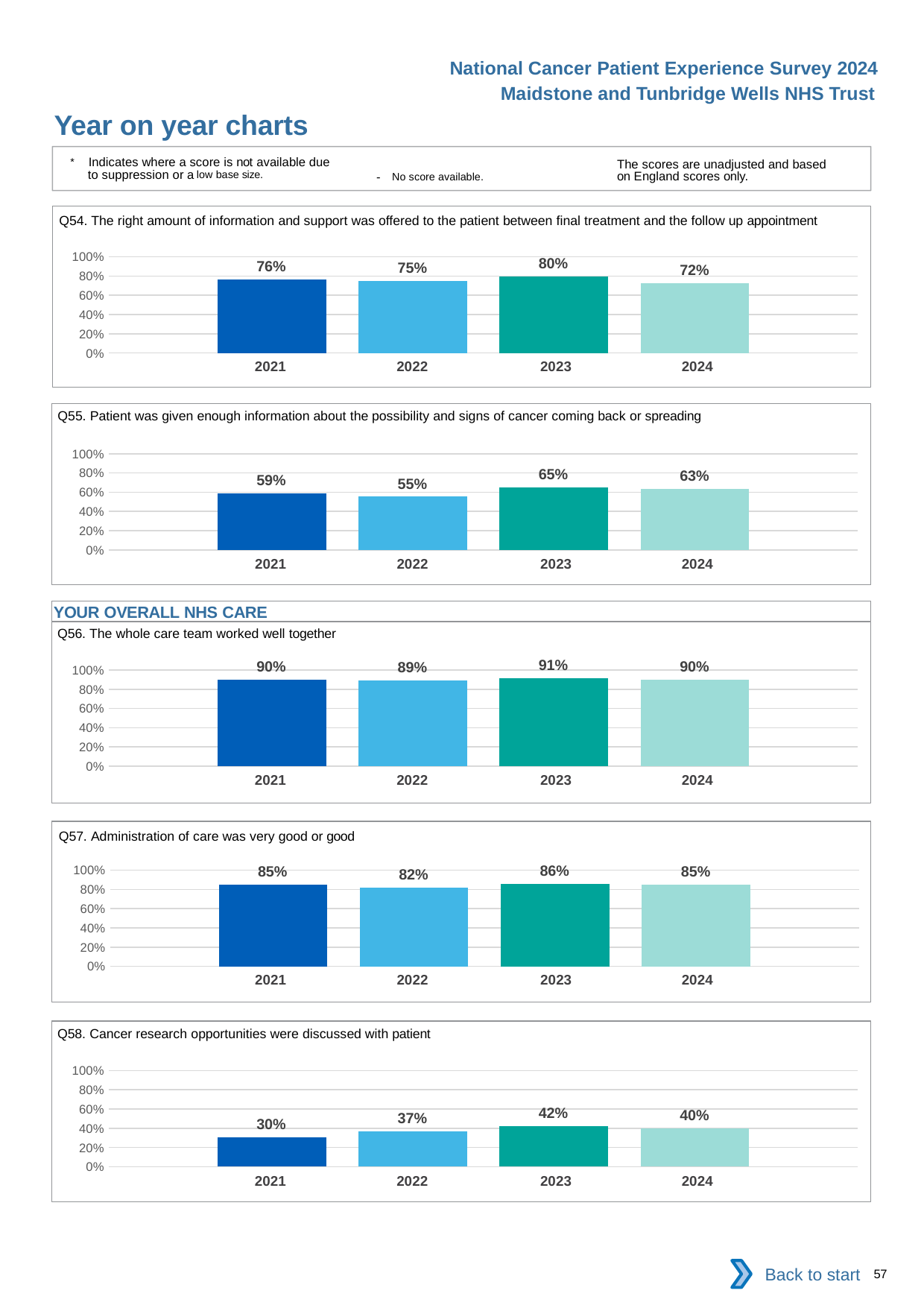
In the Q54 chart, which year had the lowest score? 2024 In the Q58 chart, what was the score for 2021? 30% In the Q57 chart, is the 2022 score greater or less than 80%? greater In the Q58 chart, did the score rise or fall from 2021 to 2023? Rise In the Q58 chart, what is the difference between the 2023 and 2021 scores? 12 percentage points What type of chart is used for Q54? Bar chart In the Q55 chart, what is the difference between the 2023 and 2022 scores? 10 percentage points How many years are shown in the Q58 chart? 4 In the Q55 chart, which year had the highest score? 2023 In the Q57 chart, which is larger, the 2021 score or the 2022 score? 2021 In the Q54 chart, what was the score for 2023? 80% In the Q56 chart, what was the score for 2022? 89%